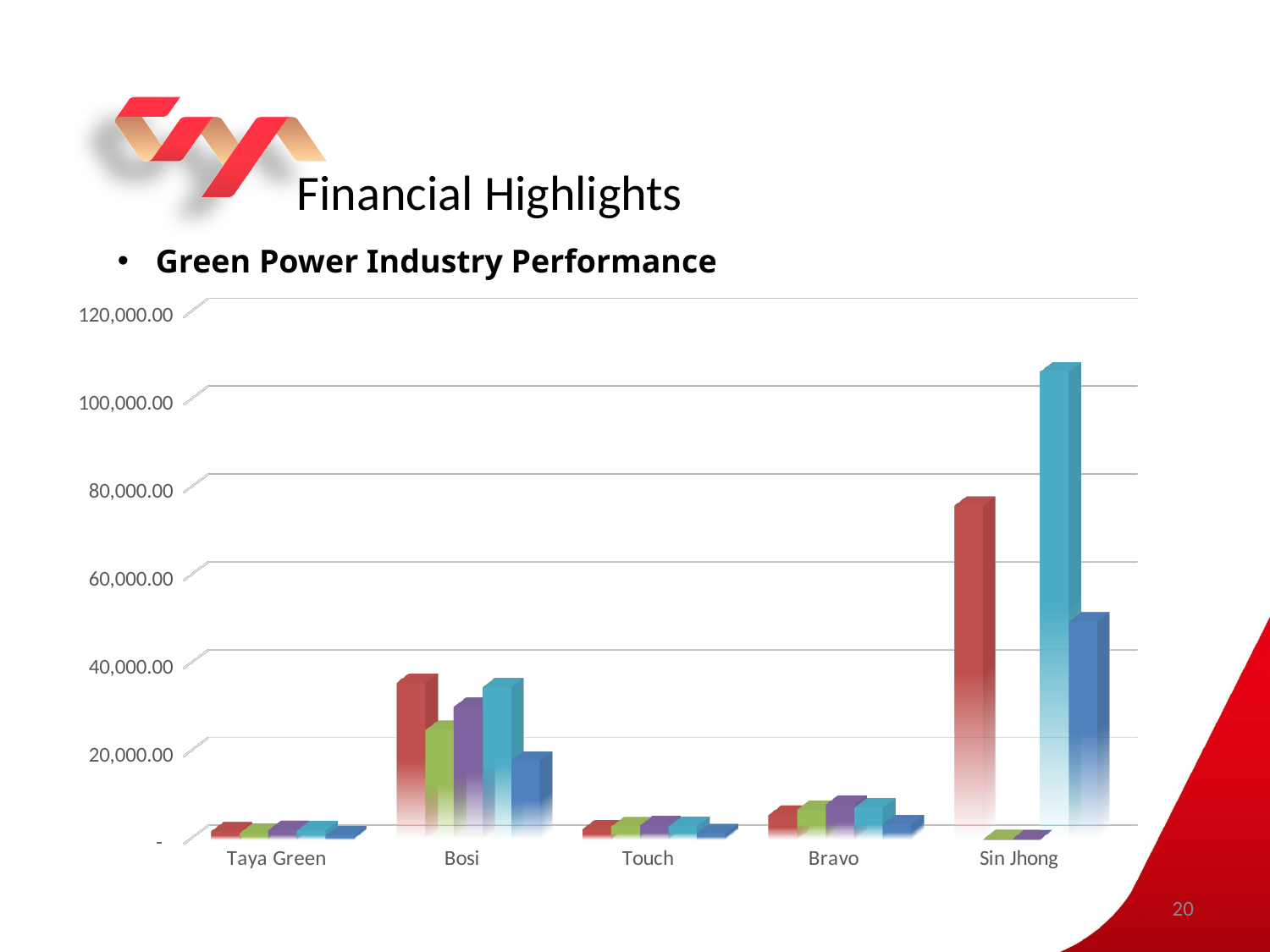
What kind of chart is shown on the slide? bar chart How many categories are shown on the x axis of the chart? 5 Are all the bars for Bravo greater or less than 20,000.00? less Which category has larger bars overall, Bosi or Bravo? Bosi Which category on the x axis contains the tallest bar in the chart? Sin Jhong Is the value of the red bar for Sin Jhong greater or less than 60,000.00? greater Is the value of the tallest bar for Sin Jhong greater or less than 100,000.00? greater Which category has the lowest bars overall in the chart? Taya Green What is the highest value labelled on the y axis of the chart? 120,000.00